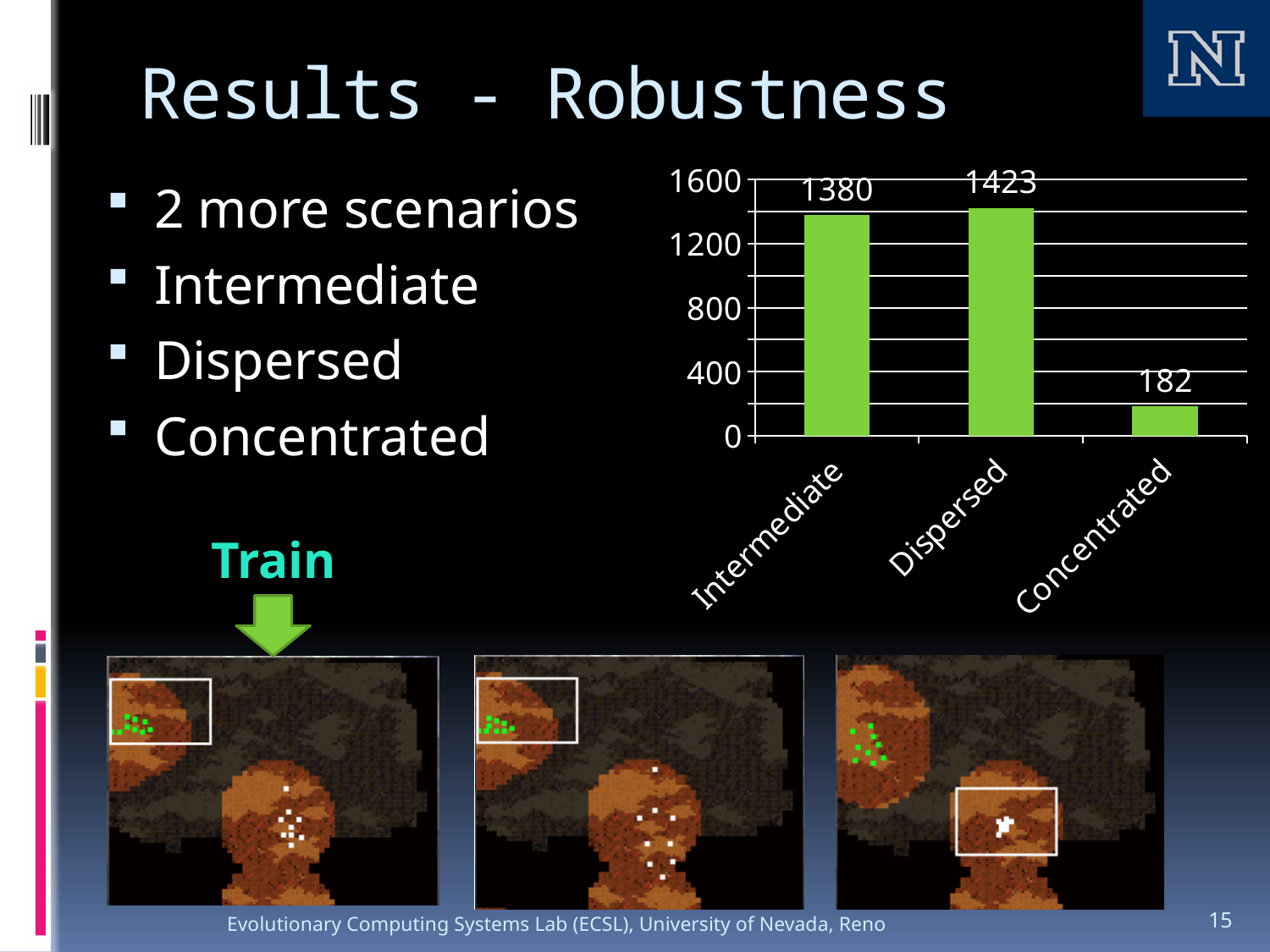
Which category has the highest value? Dispersed What is the value for Dispersed? 1423 What is the value for Intermediate? 1380 Which category has the lowest value? Concentrated What kind of chart is shown on the slide? bar chart Is the value for Concentrated greater or less than 400? less What colour are the bars in the chart? green How many categories are shown on the x axis? 3 Which is larger, the value for Intermediate or the value for Concentrated? Intermediate What is the value for Concentrated? 182 What is the difference between the values for Dispersed and Intermediate? 43 What is the difference between the values for Intermediate and Concentrated? 1198